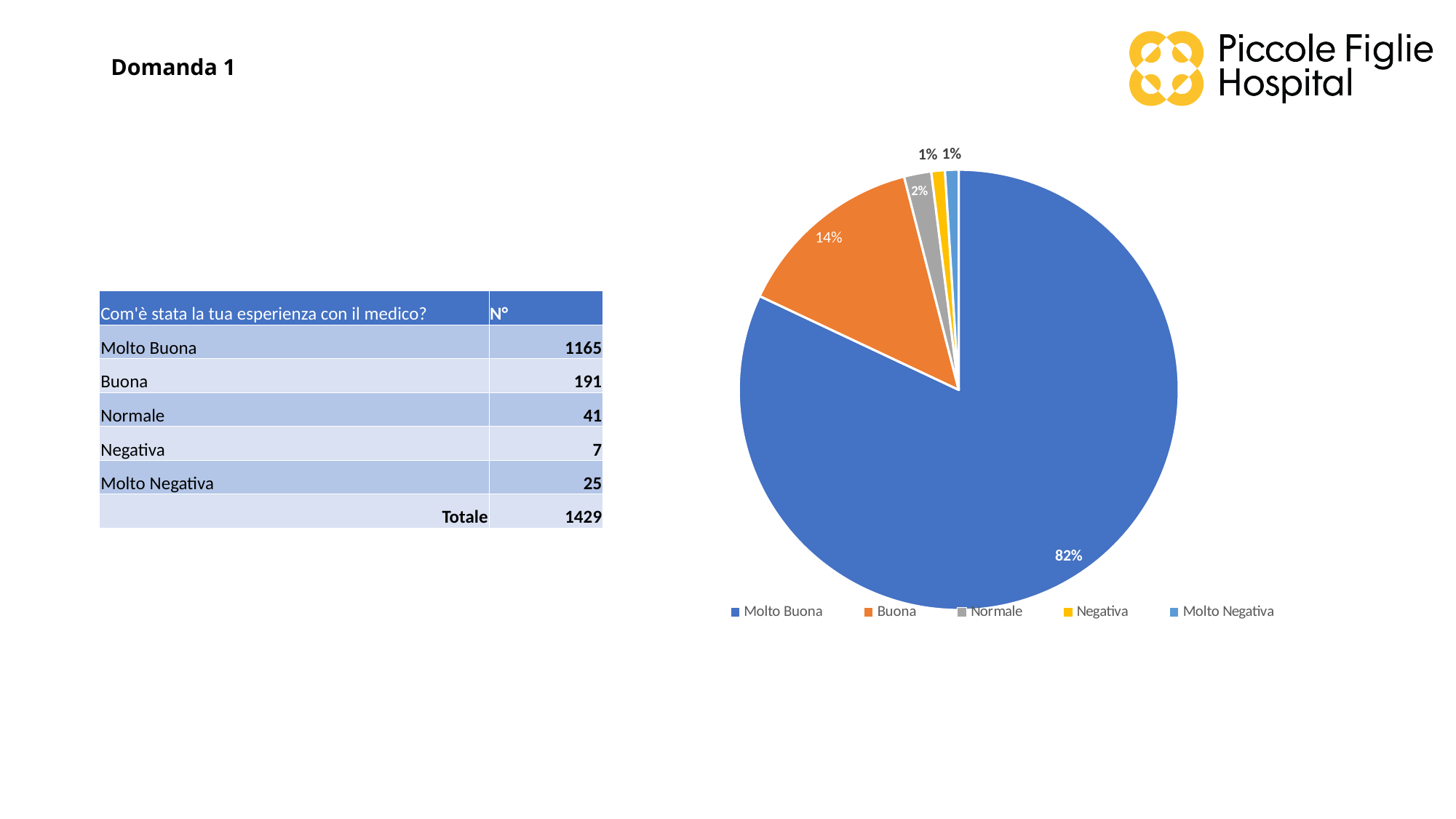
What percentage of the pie chart does the Normale slice represent? 2% Is the Molto Buona slice greater or less than 50% of the pie chart? greater Which slice is larger in the pie chart, Buona or Normale? Buona Which category is shown in yellow in the pie chart? Negativa Which category has the largest slice in the pie chart? Molto Buona How many percentage points larger is the Molto Buona slice than the Buona slice? 68 What percentage of the pie chart does the Molto Buona slice represent? 82% Which category is shown in orange in the pie chart? Buona How many categories does the pie chart legend list? 5 What percentage of the pie chart does the Buona slice represent? 14% What kind of chart is shown on the slide? pie chart